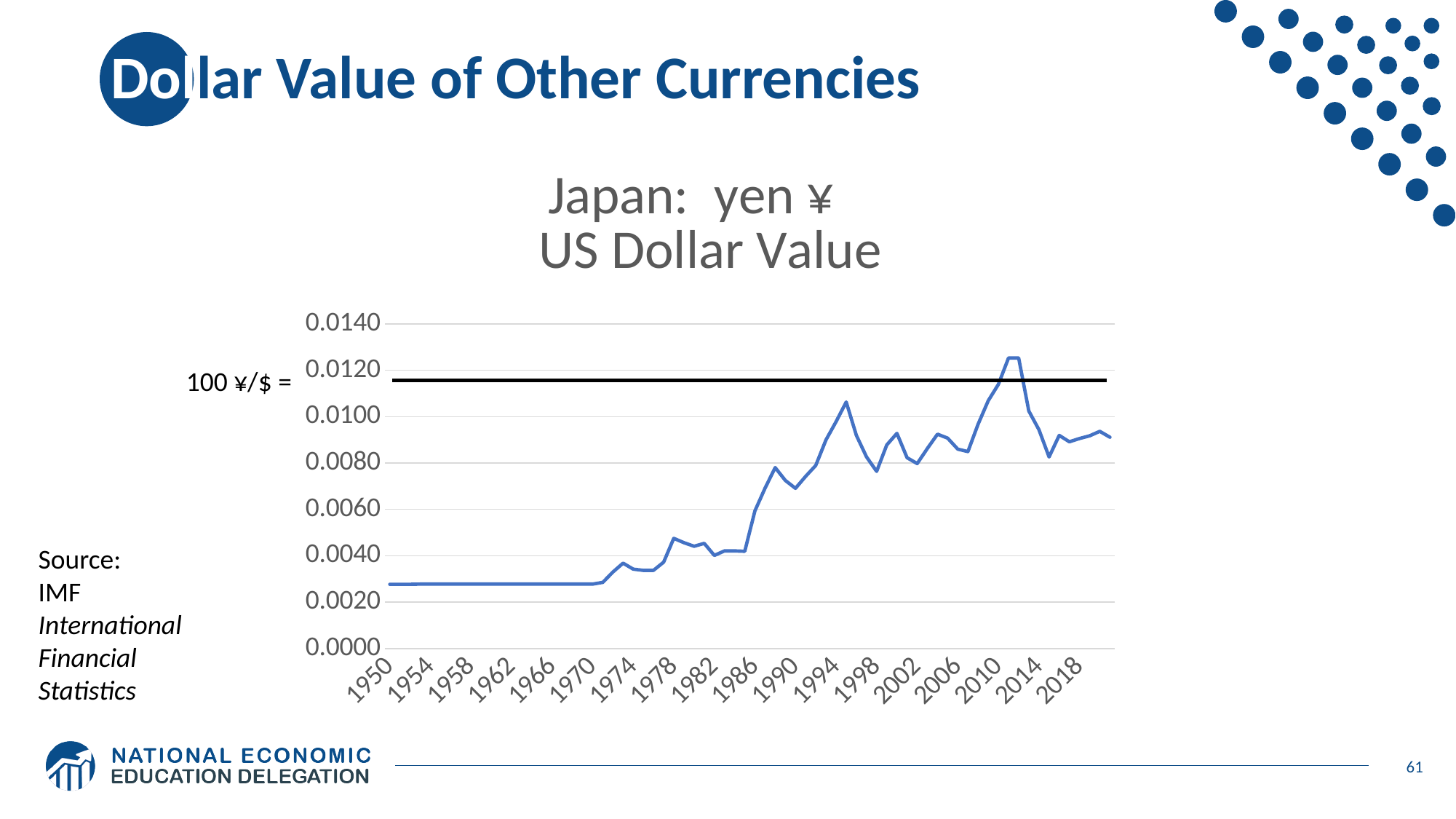
Overall, does the line rise or fall from 1950 to 2018? rise Is the highest point of the line greater or less than 0.0120? greater Is the value for 1950 greater or less than 0.0040? less What is the title of the chart? Japan: yen ¥ US Dollar Value Is the value for 2018 greater or less than 0.0100? less What label is attached to the black horizontal line on the chart? 100 ¥/$ = How many year labels are shown on the x axis? 18 What kind of chart is shown on the slide? line chart Does the line reach its highest value before or after 2010? after Which year has the larger value, 1970 or 1994? 1994